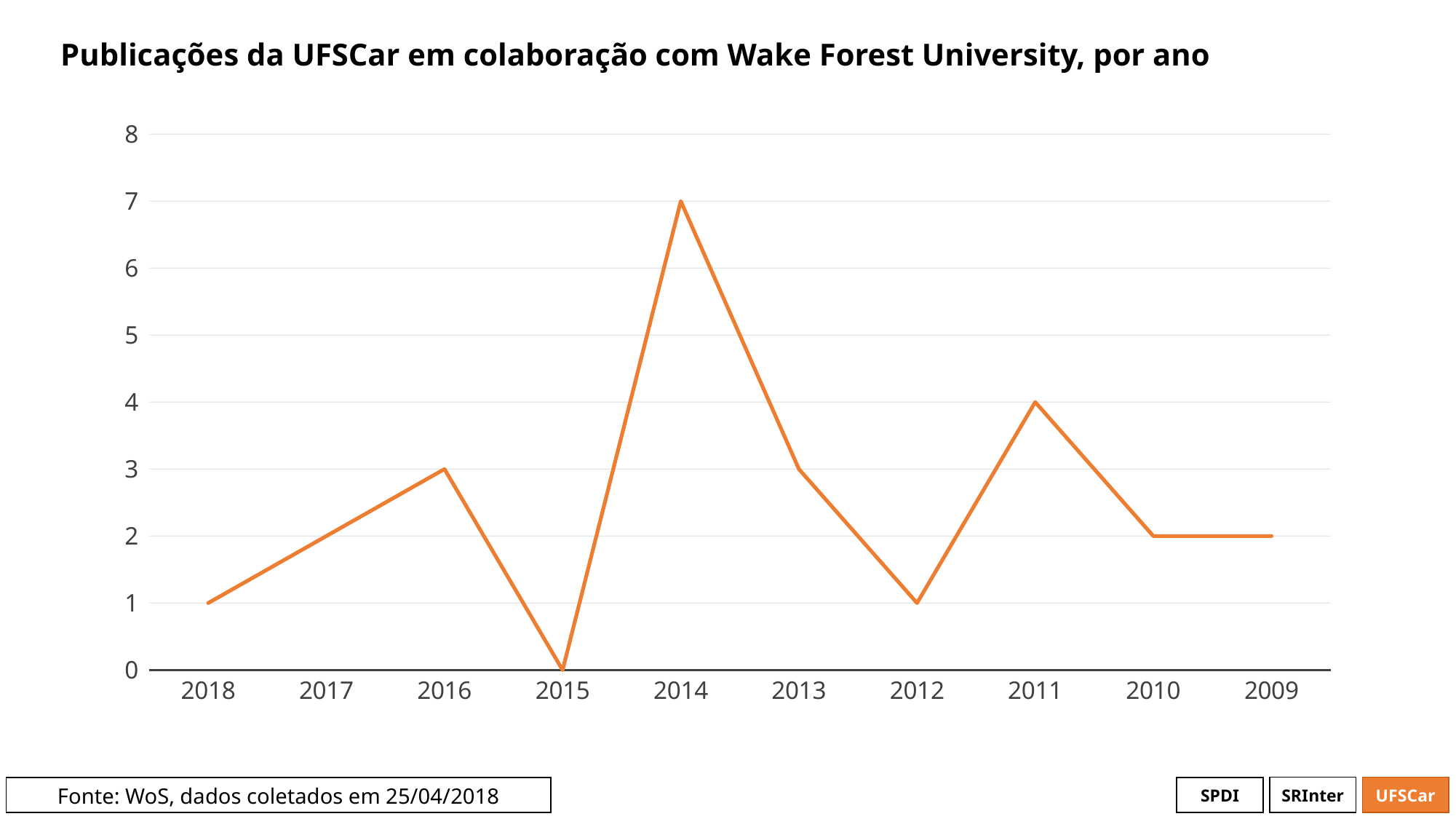
What is the difference between the number of publications in 2014 and in 2013? 4 What is the number of publications in 2011? 4 What is the number of publications in 2016? 3 What is the number of publications in 2015? 0 How many years are plotted on the x axis? 10 Which year has the lowest number of publications? 2015 Is the value for 2014 greater or less than 5? greater What is the number of publications in 2014? 7 Which year has more publications, 2011 or 2012? 2011 What is the title of the chart? Publicações da UFSCar em colaboração com Wake Forest University, por ano Which year has the highest number of publications? 2014 What type of chart is shown on the slide? line chart